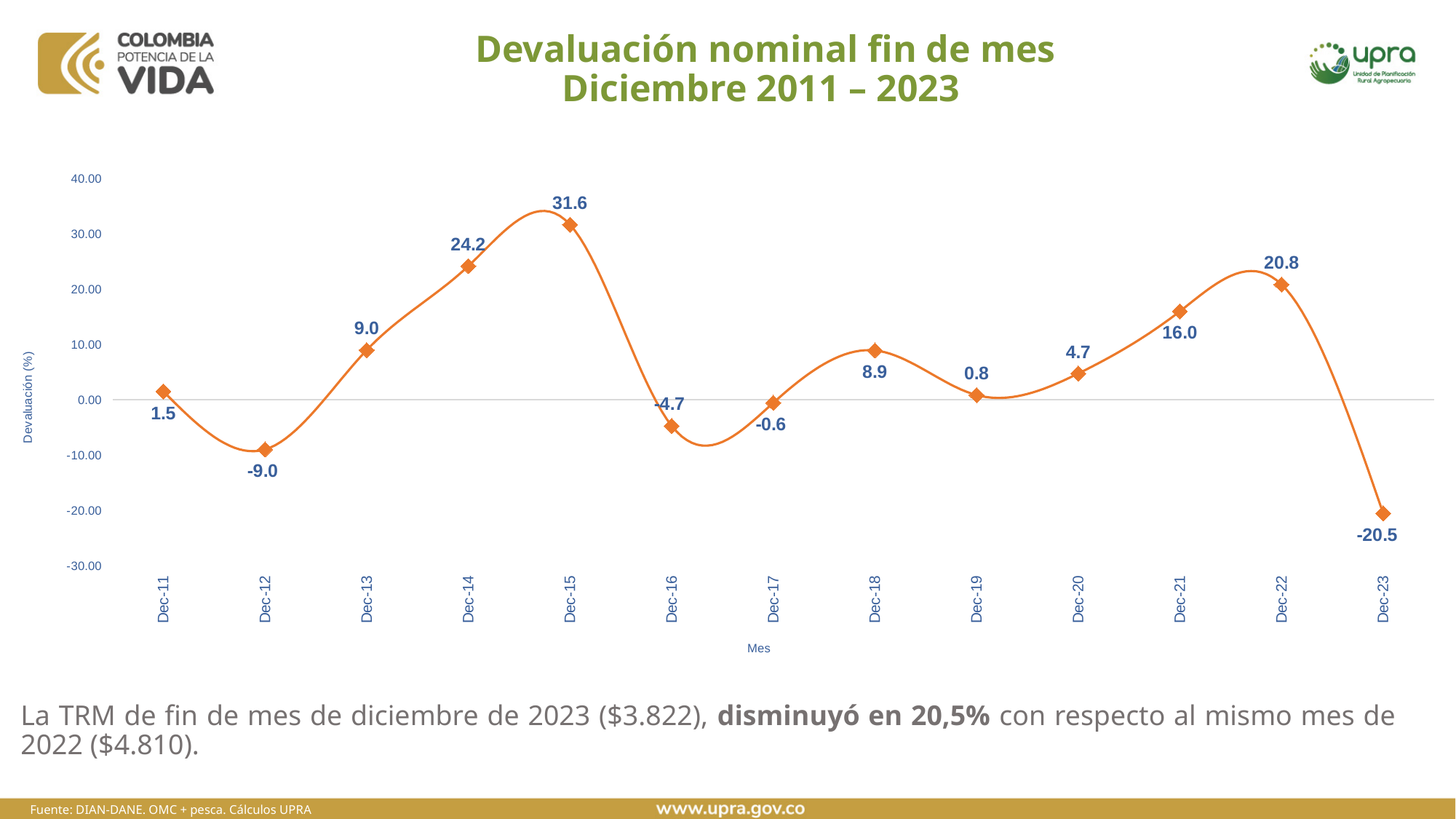
How many data points are plotted on the chart? 13 What is the difference between the values for Dec-22 and Dec-21? 4.8 What is the devaluation value for Dec-15? 31.6 Which month has the lowest devaluation value? Dec-23 What kind of chart is shown on the slide? line chart Which month has the highest devaluation value? Dec-15 What is the devaluation value for Dec-12? -9.0 Is the value for Dec-15 greater or less than 30.00? greater Do the values rise or fall from Dec-22 to Dec-23? fall What is the devaluation value for Dec-23? -20.5 Which is larger, the value for Dec-14 or the value for Dec-22? Dec-14 What is the label of the y axis? Devaluación (%)